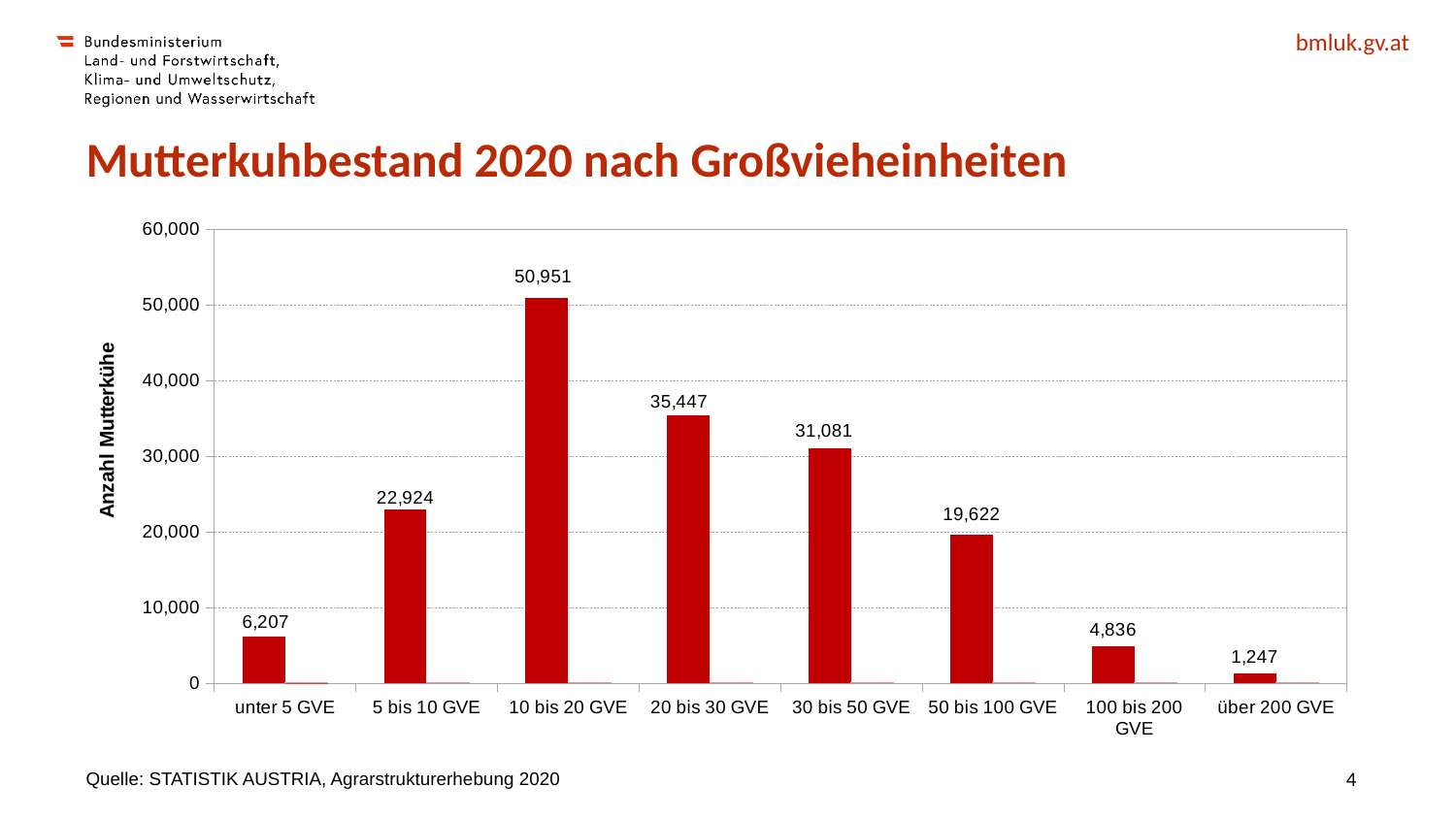
How many GVE categories are shown on the x axis? 8 Which is larger: the value for '5 bis 10 GVE' or the value for '50 bis 100 GVE'? 5 bis 10 GVE What is the number of Mutterkühe for the category '10 bis 20 GVE'? 50,951 What is the label of the y axis? Anzahl Mutterkühe Which category has the highest number of Mutterkühe? 10 bis 20 GVE Is the value for '30 bis 50 GVE' greater or less than 30,000? greater Which category has the lowest number of Mutterkühe? über 200 GVE What is the title of the chart? Mutterkuhbestand 2020 nach Großvieheinheiten What kind of chart is shown on the slide? bar chart What is the value shown for '50 bis 100 GVE'? 19,622 What is the value shown for 'über 200 GVE'? 1,247 What is the difference between the values for '20 bis 30 GVE' and '30 bis 50 GVE'? 4,366